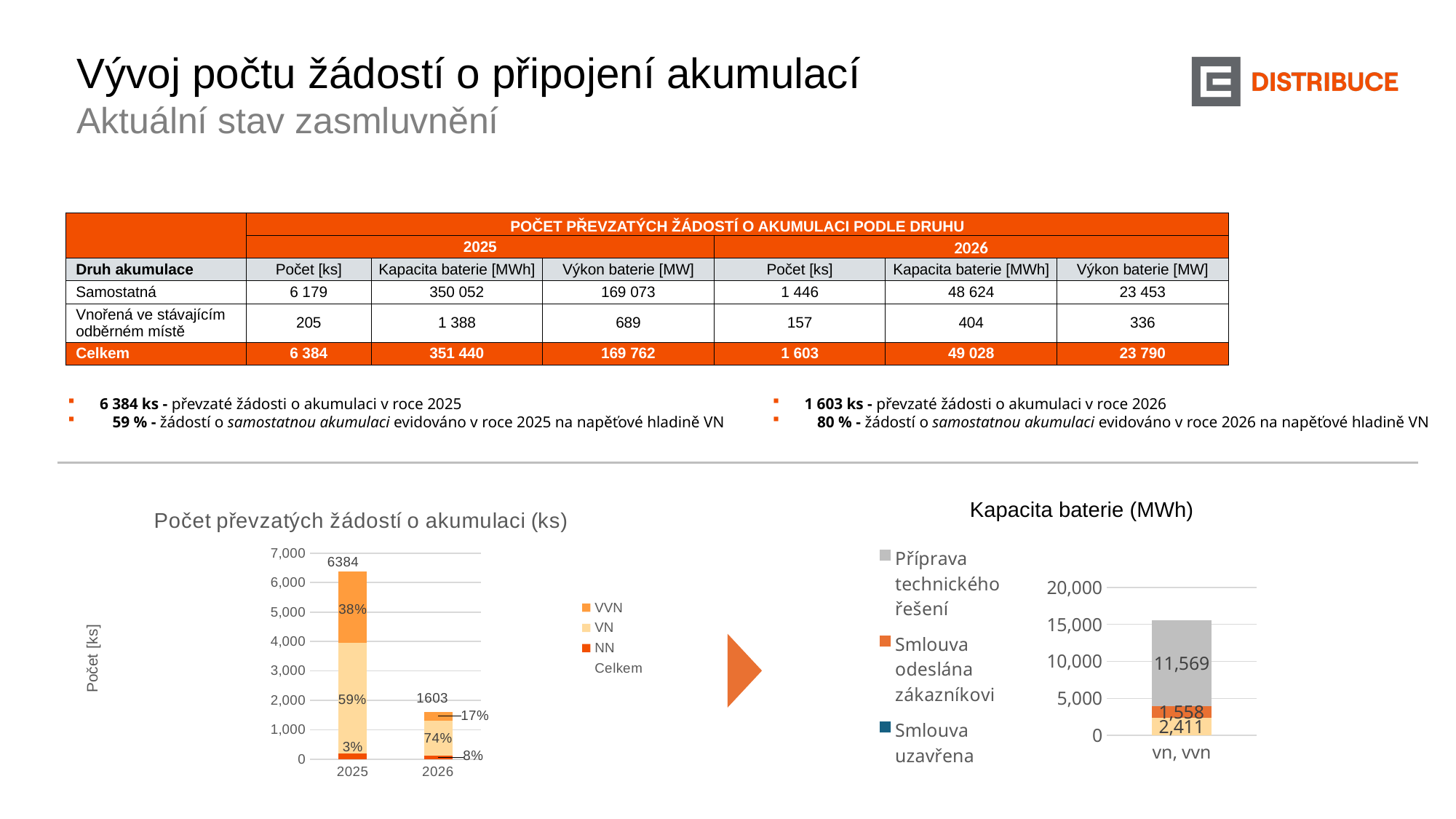
In the chart 'Počet převzatých žádostí o akumulaci (ks)', what is the difference between the 2025 total and the 2026 total? 4781 In the chart 'Počet převzatých žádostí o akumulaci (ks)', what is the total value labelled for 2026? 1603 In the chart 'Počet převzatých žádostí o akumulaci (ks)', does the total rise or fall from 2025 to 2026? Fall In the chart 'Počet převzatých žádostí o akumulaci (ks)', what percentage is labelled for the NN segment in 2025? 3% What kind of chart is 'Počet převzatých žádostí o akumulaci (ks)'? Stacked bar chart In the chart 'Kapacita baterie (MWh)', what is the value labelled for 'Smlouva odeslána zákazníkovi'? 1,558 How many series does the legend of the chart 'Kapacita baterie (MWh)' list? 3 In the chart 'Počet převzatých žádostí o akumulaci (ks)', what percentage is labelled for the VN segment in 2025? 59% In the chart 'Počet převzatých žádostí o akumulaci (ks)', what is the total value labelled for 2025? 6384 In the chart 'Počet převzatých žádostí o akumulaci (ks)', what percentage is labelled for the VVN segment in 2026? 17% In the chart 'Kapacita baterie (MWh)', what is the value labelled for 'Příprava technického řešení'? 11,569 In the chart 'Počet převzatých žádostí o akumulaci (ks)', which year has the higher total? 2025